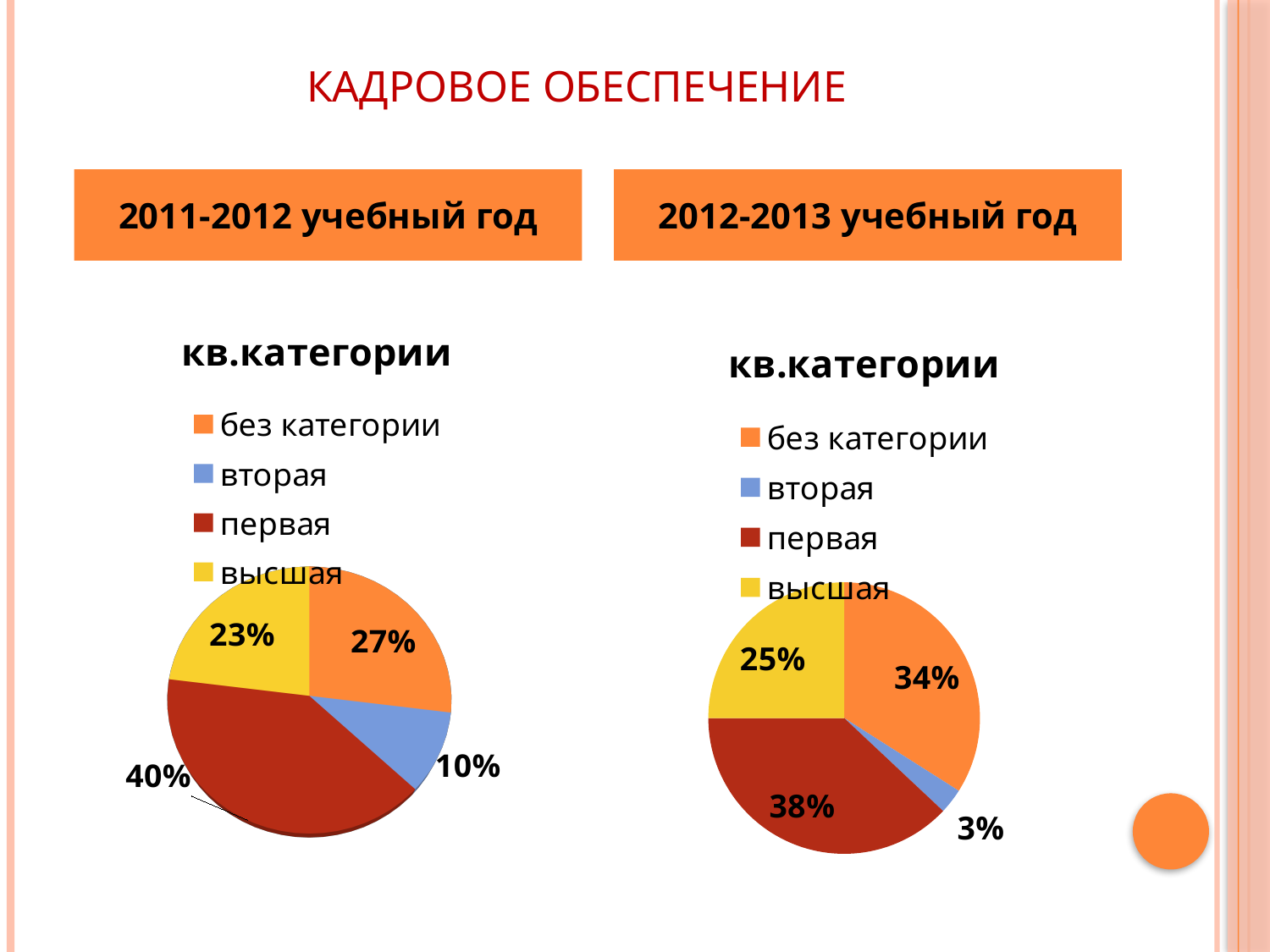
In the pie chart for 2012-2013 учебный год, what share is labelled for без категории? 34% In the pie chart for 2012-2013 учебный год, which is larger: без категории or первая? первая What is the title shown above each of the two charts? кв.категории What is the difference between the share of вторая in the 2011-2012 chart and in the 2012-2013 chart? 7% In the pie chart for 2011-2012 учебный год, which category has the smallest slice? вторая What type of chart is used for the 2012-2013 учебный год data? pie chart In the pie chart for 2011-2012 учебный год, what share is labelled for первая? 40% In the pie chart for 2012-2013 учебный год, what share is labelled for высшая? 25% In the pie chart for 2011-2012 учебный год, which category has the largest slice? первая In the pie chart for 2011-2012 учебный год, what share is labelled for вторая? 10% In the pie chart for 2012-2013 учебный год, which category has the smallest slice? вторая How many categories does the legend of the 2011-2012 учебный год chart list? 4